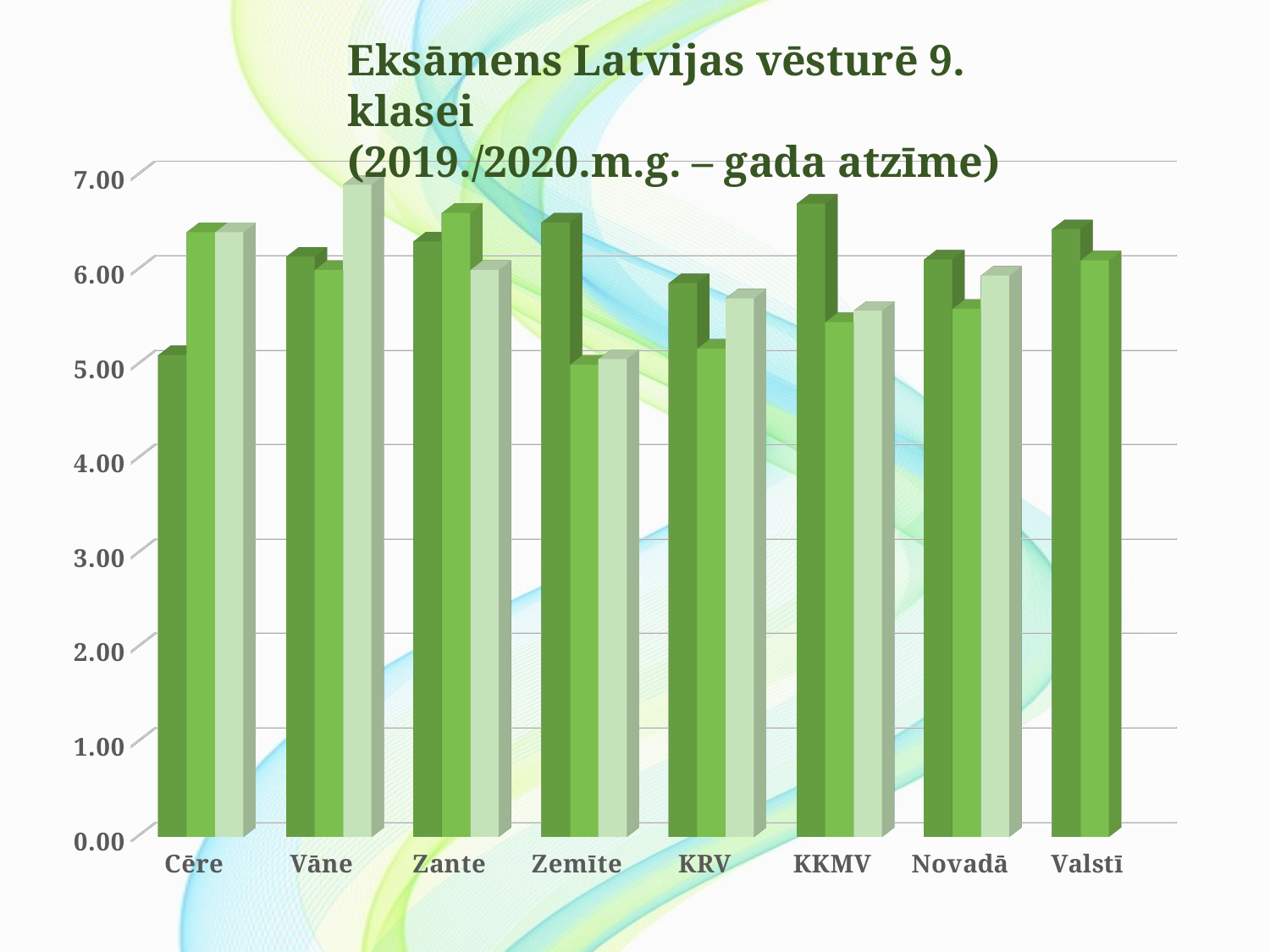
Is the value of the dark green bar for KKMV greater or less than 6.00? greater For Cēre, which is larger: the dark green bar or the medium green bar? the medium green bar Is the value of the medium green bar for Zemīte greater or less than 6.00? less Is the value of the dark green bar for Cēre greater or less than 6.00? less What kind of chart is shown on the slide? bar chart For Zemīte, which is larger: the dark green bar or the medium green bar? the dark green bar Which category has the lowest dark green bar? Cēre How many categories are shown on the x axis of the chart? 8 What is the title of the chart? Eksāmens Latvijas vēsturē 9. klasei (2019./2020.m.g. – gada atzīme) Which category has the highest light green bar? Vāne